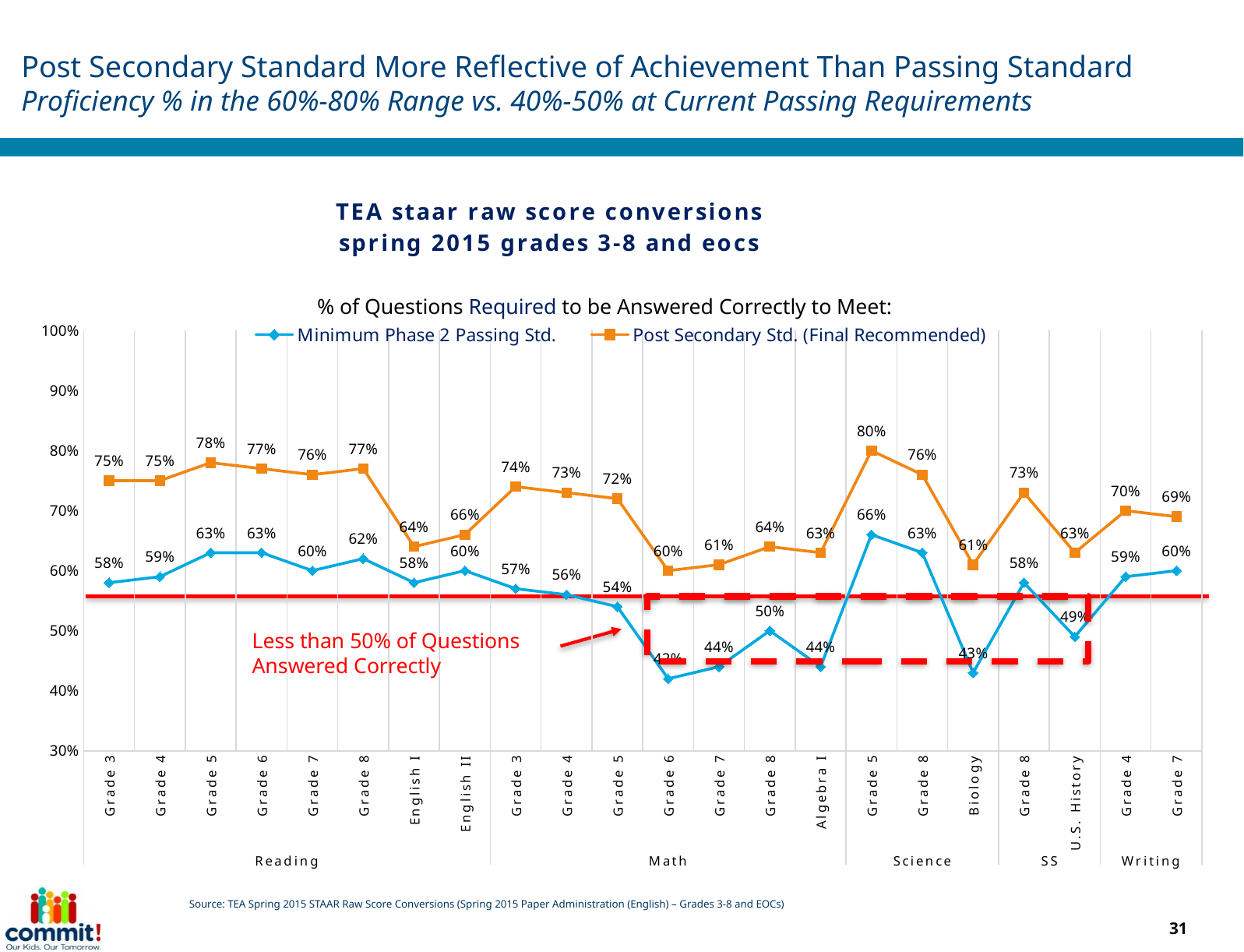
What is the Minimum Phase 2 Passing Std. value for Biology? 43% Which category has the highest Post Secondary Std. (Final Recommended) value? Science Grade 5 How many categories are plotted along the x axis? 22 Which category has the lowest Post Secondary Std. (Final Recommended) value? Math Grade 6 What is the Post Secondary Std. (Final Recommended) value for Science Grade 5? 80% How many series does the chart's legend list? 2 For Writing Grade 7, what is the difference between the Post Secondary Std. value and the Minimum Phase 2 Passing Std. value? 9 percentage points Which is larger for the Minimum Phase 2 Passing Std.: Science Grade 5 or Reading Grade 5? Science Grade 5 What kind of chart is shown on the slide? line chart What is the Post Secondary Std. (Final Recommended) value for U.S. History? 63% What is the Minimum Phase 2 Passing Std. value for Math Grade 8? 50% For Reading Grade 5, what is the difference between the Post Secondary Std. value and the Minimum Phase 2 Passing Std. value? 15 percentage points